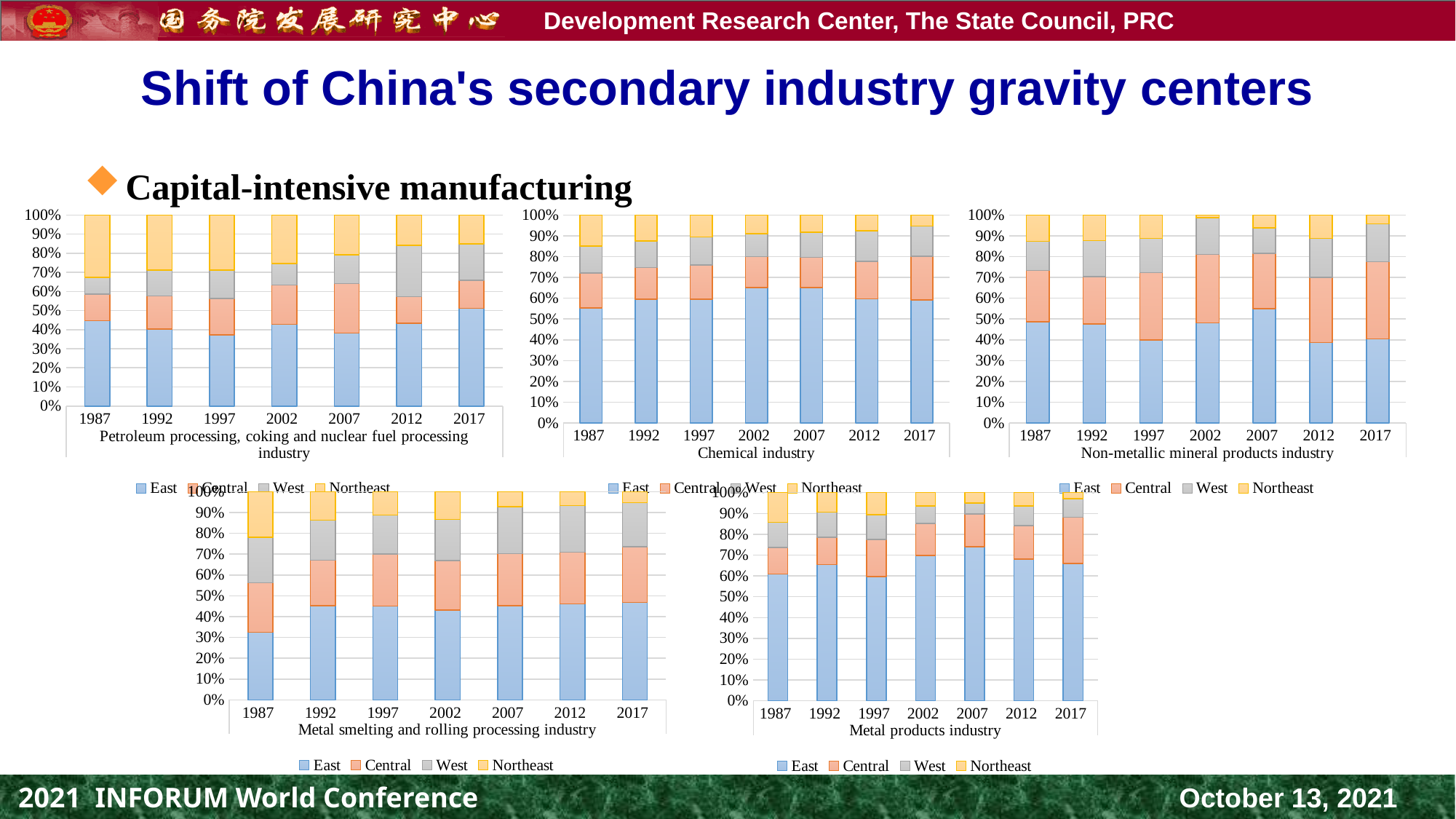
In the 'Petroleum processing, coking and nuclear fuel processing industry' chart, does the Northeast share rise or fall from 1987 to 2017? fall In the 'Metal products industry' chart, which year has the larger East share, 1997 or 2007? 2007 In the 'Metal smelting and rolling processing industry' chart, is the East share in 1987 greater or less than 40%? less In the 'Chemical industry' chart, is the East share in 2002 greater or less than 60%? greater How many charts are shown on the slide? 5 In the 'Non-metallic mineral products industry' chart, is the East share in 2017 greater or less than 50%? less Which series is shown in blue in the 'Chemical industry' chart? East In the 'Petroleum processing, coking and nuclear fuel processing industry' chart, how many years are shown on the x axis? 7 How many series does the legend of the 'Metal products industry' chart list? 4 What kind of chart is the 'Chemical industry' chart? stacked bar chart